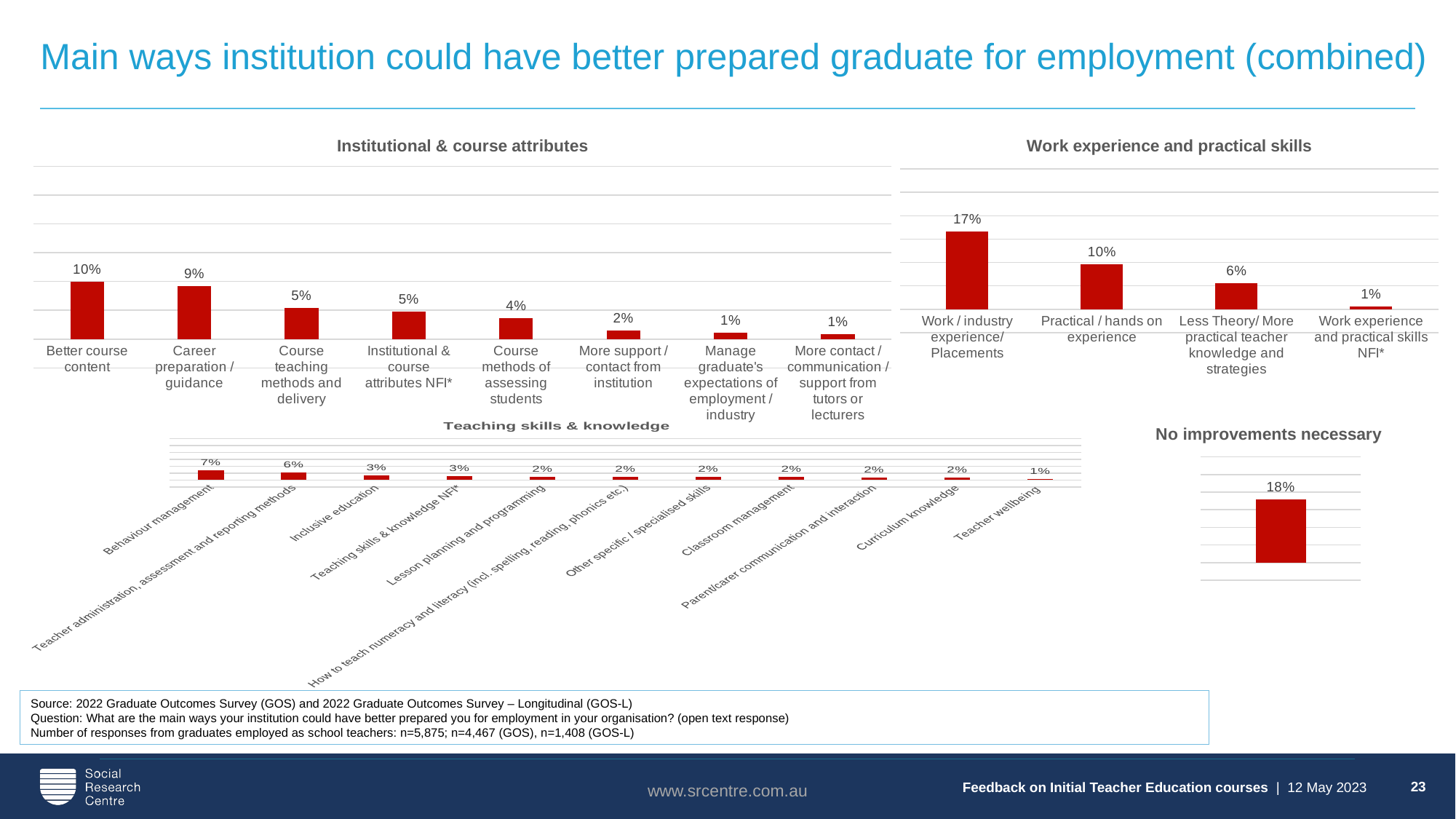
How many categories are shown in the 'Institutional & course attributes' chart? 8 In the 'Teaching skills & knowledge' chart, what is the value for Behaviour management? 7% In the 'Institutional & course attributes' chart, which category has the highest value? Better course content In the 'Work experience and practical skills' chart, what is the value for Work / industry experience/ Placements? 17% In the 'Institutional & course attributes' chart, what is the difference between Career preparation / guidance and Course methods of assessing students? 5% In the 'Work experience and practical skills' chart, which is larger: Practical / hands on experience or Less Theory/ More practical teacher knowledge and strategies? Practical / hands on experience In the 'No improvements necessary' chart, what value is shown? 18% How many categories are shown in the 'Work experience and practical skills' chart? 4 In the 'Institutional & course attributes' chart, what is the value for Better course content? 10% What type of chart is the 'Work experience and practical skills' chart? Bar chart In the 'Teaching skills & knowledge' chart, which category has the lowest value? Teacher wellbeing In the 'Work experience and practical skills' chart, which category has the lowest value? Work experience and practical skills NFI*